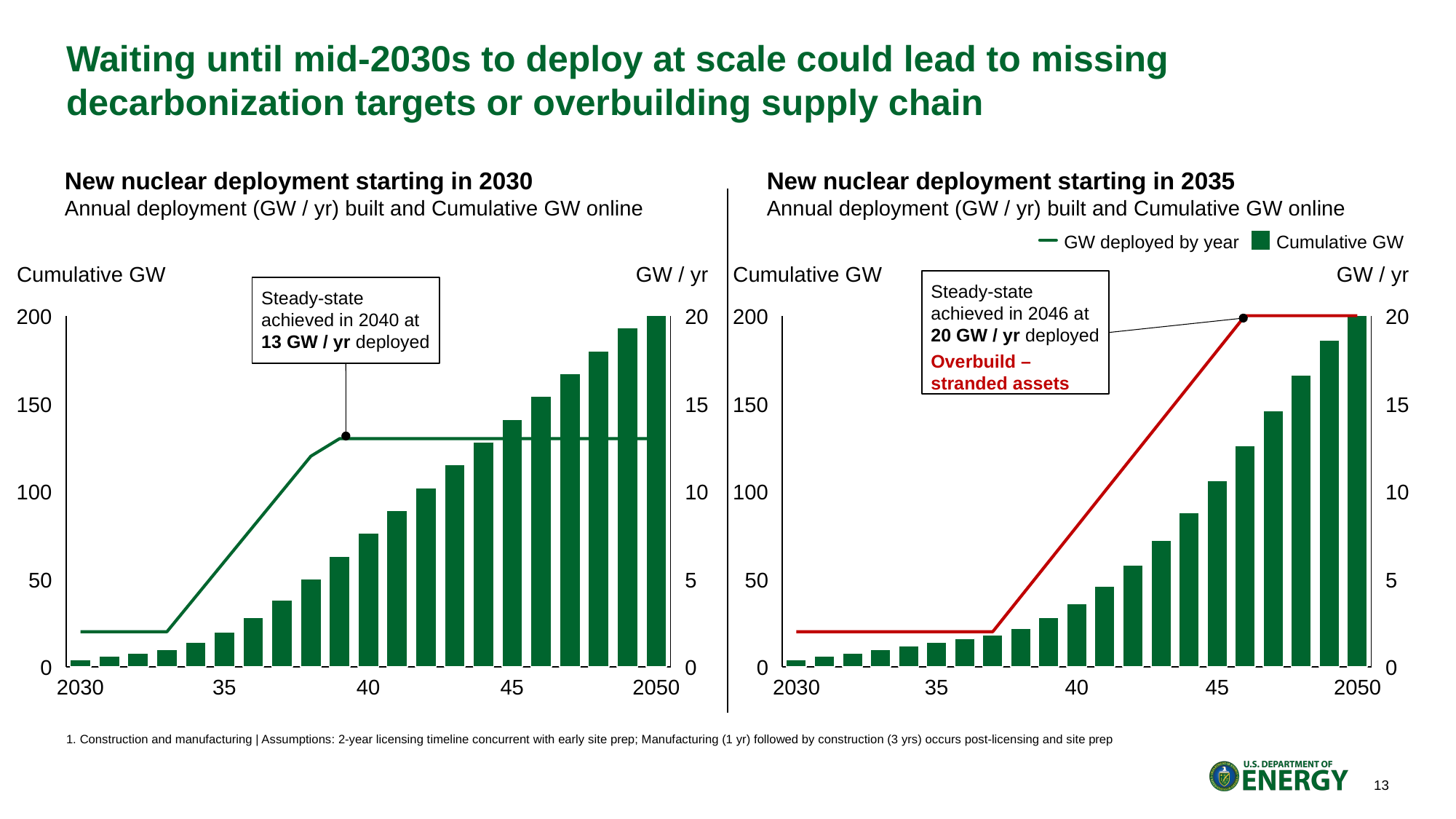
What is the difference between the steady-state deployment rates in the 2035-start chart and the 2030-start chart? 7 GW / yr What warning is written in red in the annotation on the chart 'New nuclear deployment starting in 2035'? Overbuild – stranded assets How many series does the legend on the right-hand chart list? 2 In the chart 'New nuclear deployment starting in 2035', do the Cumulative GW bars rise or fall from 2030 to 2050? Rise In the chart 'New nuclear deployment starting in 2030', in which year is steady-state achieved according to the annotation? 2040 In the chart 'New nuclear deployment starting in 2030', is the Cumulative GW value for 2045 greater or less than 100? greater Which chart shows the higher steady-state deployment rate, the one starting in 2030 or the one starting in 2035? Starting in 2035 In the chart 'New nuclear deployment starting in 2035', what deployment rate is reached at steady-state? 20 GW / yr What kind of chart is used in 'New nuclear deployment starting in 2030'? Combined bar and line chart In the chart 'New nuclear deployment starting in 2035', is the Cumulative GW value for 2040 greater or less than 50? less In the chart 'New nuclear deployment starting in 2030', what deployment rate is reached at steady-state? 13 GW / yr In the chart 'New nuclear deployment starting in 2035', in which year is steady-state achieved according to the annotation? 2046